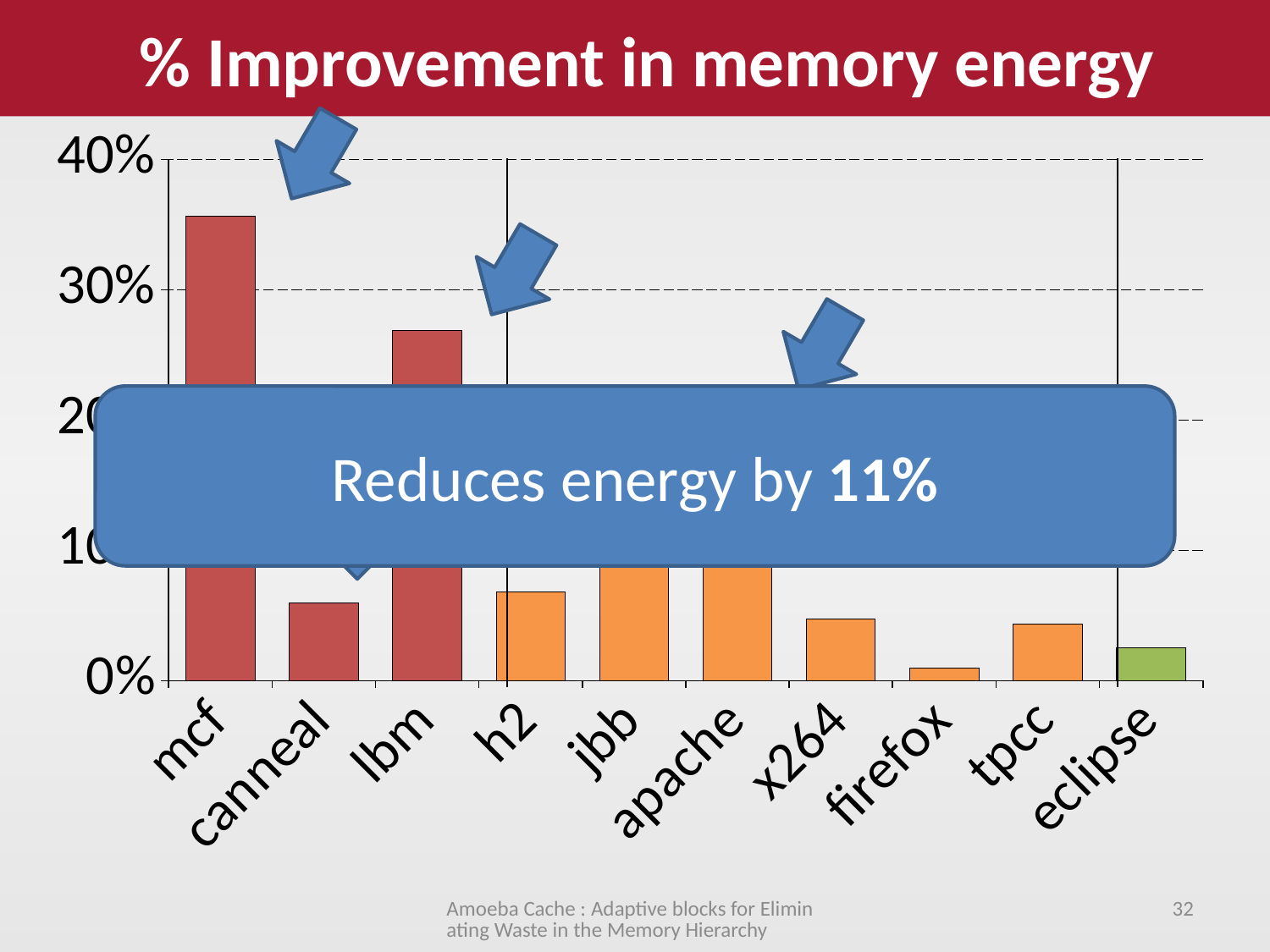
Is the value for mcf greater or less than 30%? greater Is the value for lbm greater or less than 30%? less What colour is the bar for eclipse? green Which category has the lowest % improvement in memory energy? firefox What kind of chart is shown on the slide? bar chart What is the title of the chart? % Improvement in memory energy How many categories are shown on the x axis of the chart? 10 Which is larger, the value for mcf or the value for lbm? mcf Is the value for lbm greater or less than 20%? greater Which is larger, the value for canneal or the value for firefox? canneal Which category has the highest % improvement in memory energy? mcf